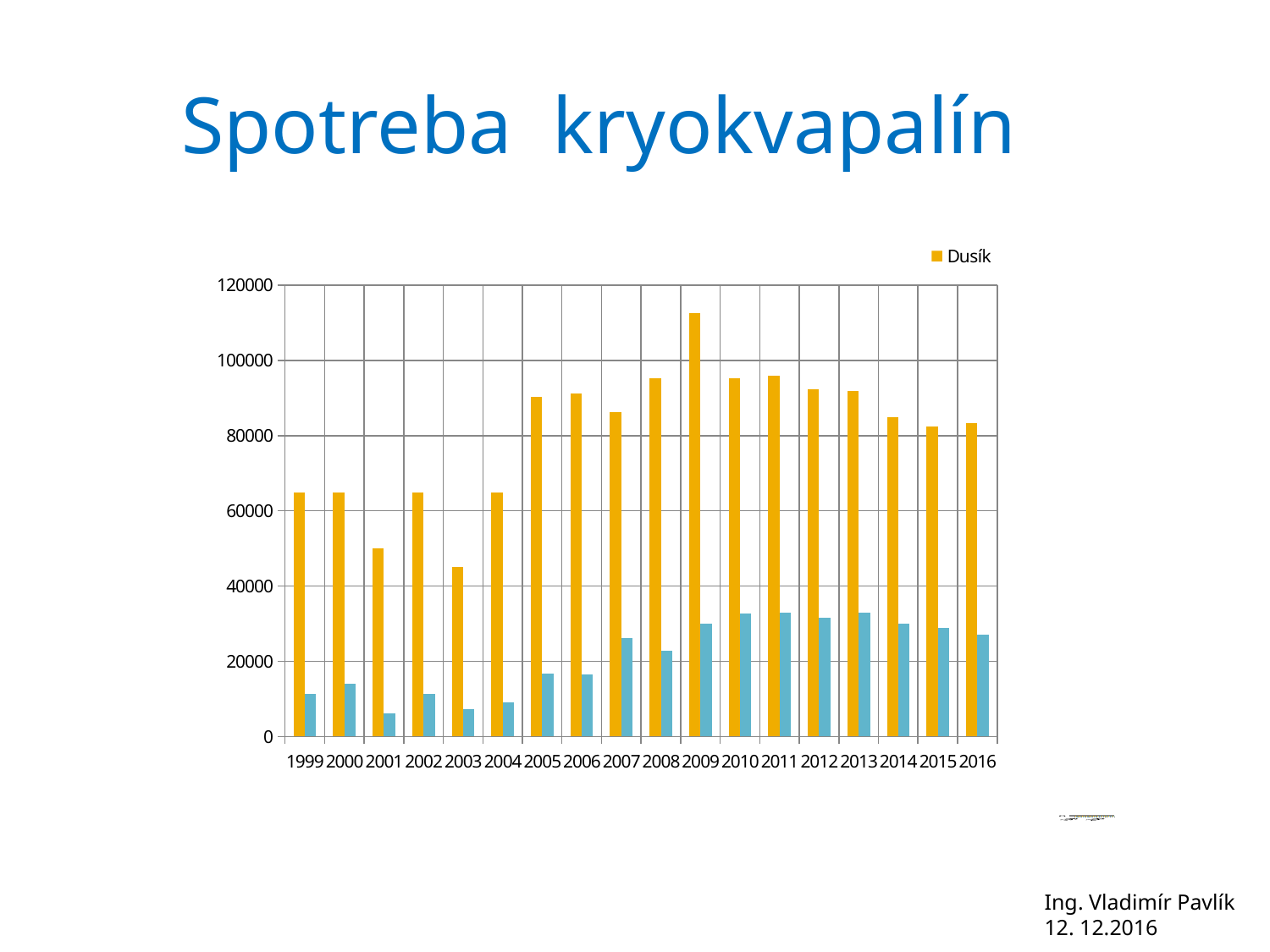
How many years are shown on the x axis of the chart? 18 Is the value of the blue series for 2011 greater or less than 20000? greater Is the Dusík value for 2005 greater or less than 80000? greater Is the Dusík value for 2003 greater or less than 60000? less What kind of chart is shown on the slide? bar chart Which series name is shown in the chart legend? Dusík Do the Dusík values rise or fall from 2011 to 2015? fall In which year is the Dusík value highest? 2009 What is the title of the slide containing the chart? Spotreba kryokvapalín Which year has the larger Dusík value, 2001 or 2002? 2002 In which year is the Dusík value lowest? 2003